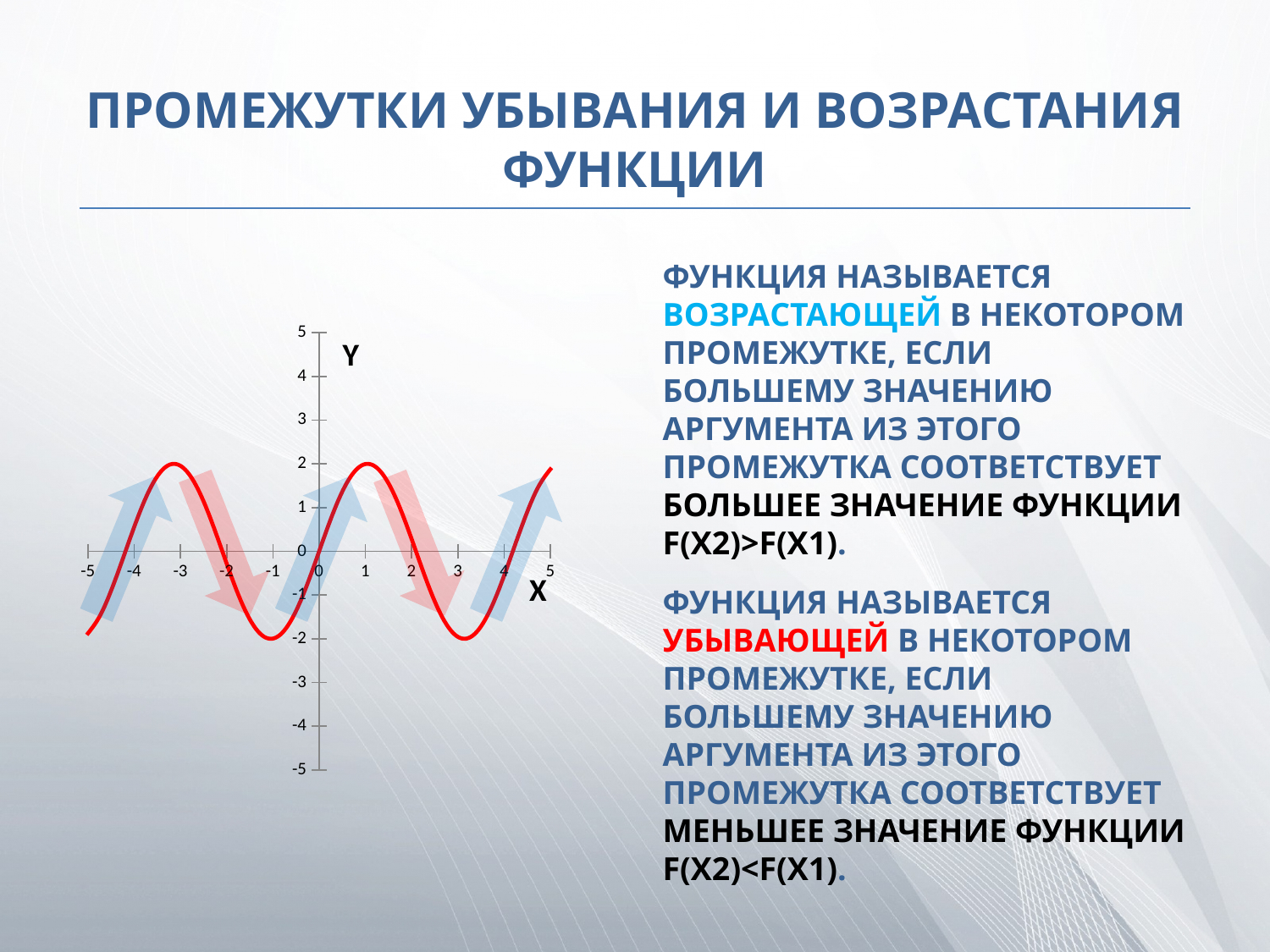
Is the value of the function at x = 3 greater or less than 0? less What is the label of the vertical axis? Y What is the lowest value on the y axis that the curve reaches? -2 Is the value of the function at x = 1 greater or less than 1? greater Is the value of the function at x = -1 greater or less than 0? less What is the highest value on the y axis that the curve reaches? 2 Between x = 1 and x = 3, does the curve rise or fall? fall What kind of chart is shown on the slide? line chart What is the label of the horizontal axis? X Between x = -5 and x = -3, does the curve rise or fall? rise